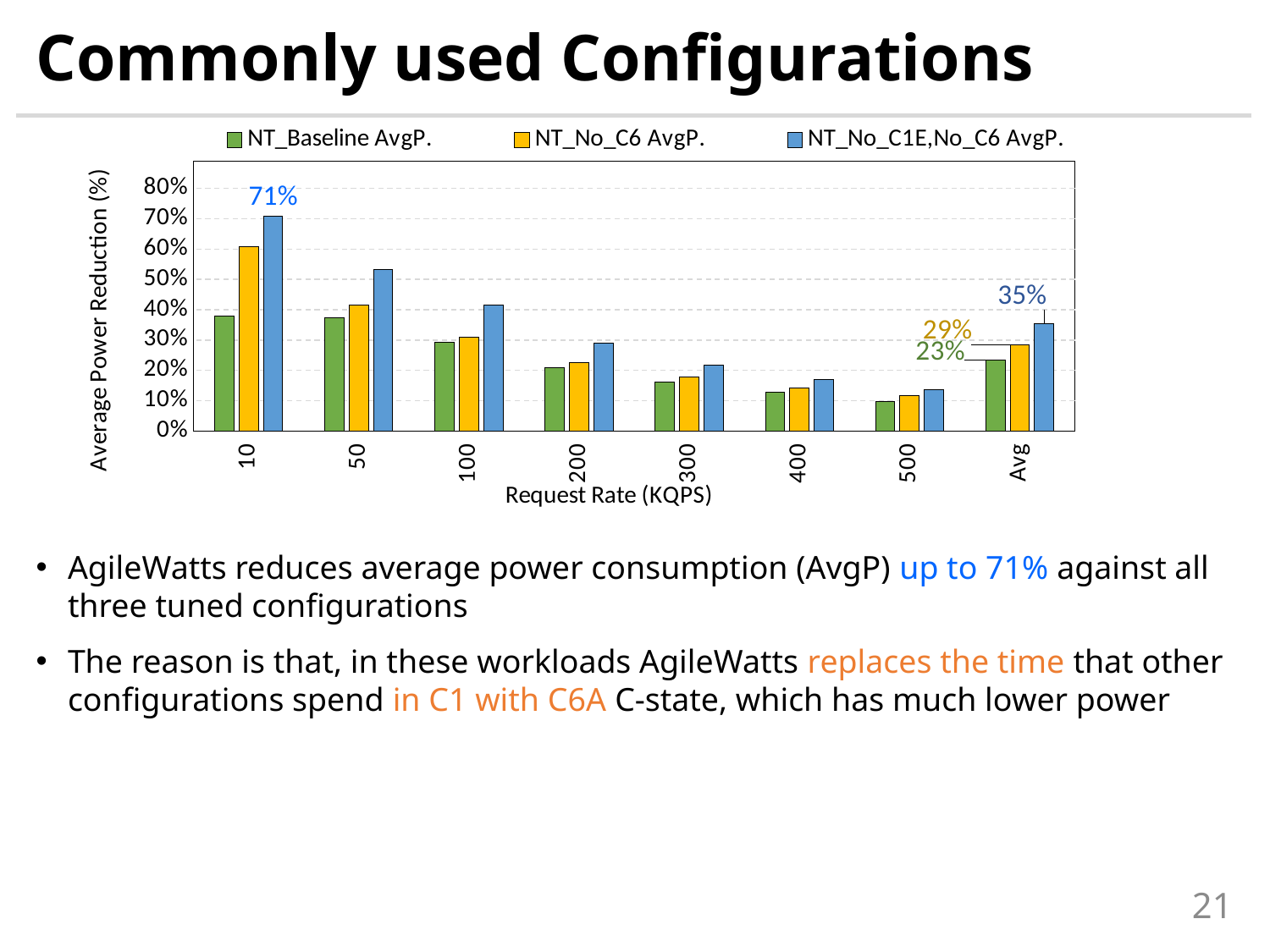
What is the value of NT_No_C1E,No_C6 AvgP. for the Avg category? 35% What is the value of NT_Baseline AvgP. for the Avg category? 23% What is the value of NT_No_C1E,No_C6 AvgP. at a request rate of 10 KQPS? 71% How many series does the legend list? 3 What kind of chart is shown on the slide? Bar chart In the Avg category, how much higher is NT_No_C1E,No_C6 AvgP. than NT_Baseline AvgP.? 12% How many categories are shown on the x axis? 8 What is the value of NT_No_C6 AvgP. for the Avg category? 29% At which request rate does NT_No_C1E,No_C6 AvgP. reach its highest value? 10 Do the NT_No_C1E,No_C6 AvgP. values rise or fall as the request rate increases from 10 to 500? fall At which request rate is NT_Baseline AvgP. lowest? 500 Is the value for NT_No_C6 AvgP. at a request rate of 10 greater or less than 50%? greater